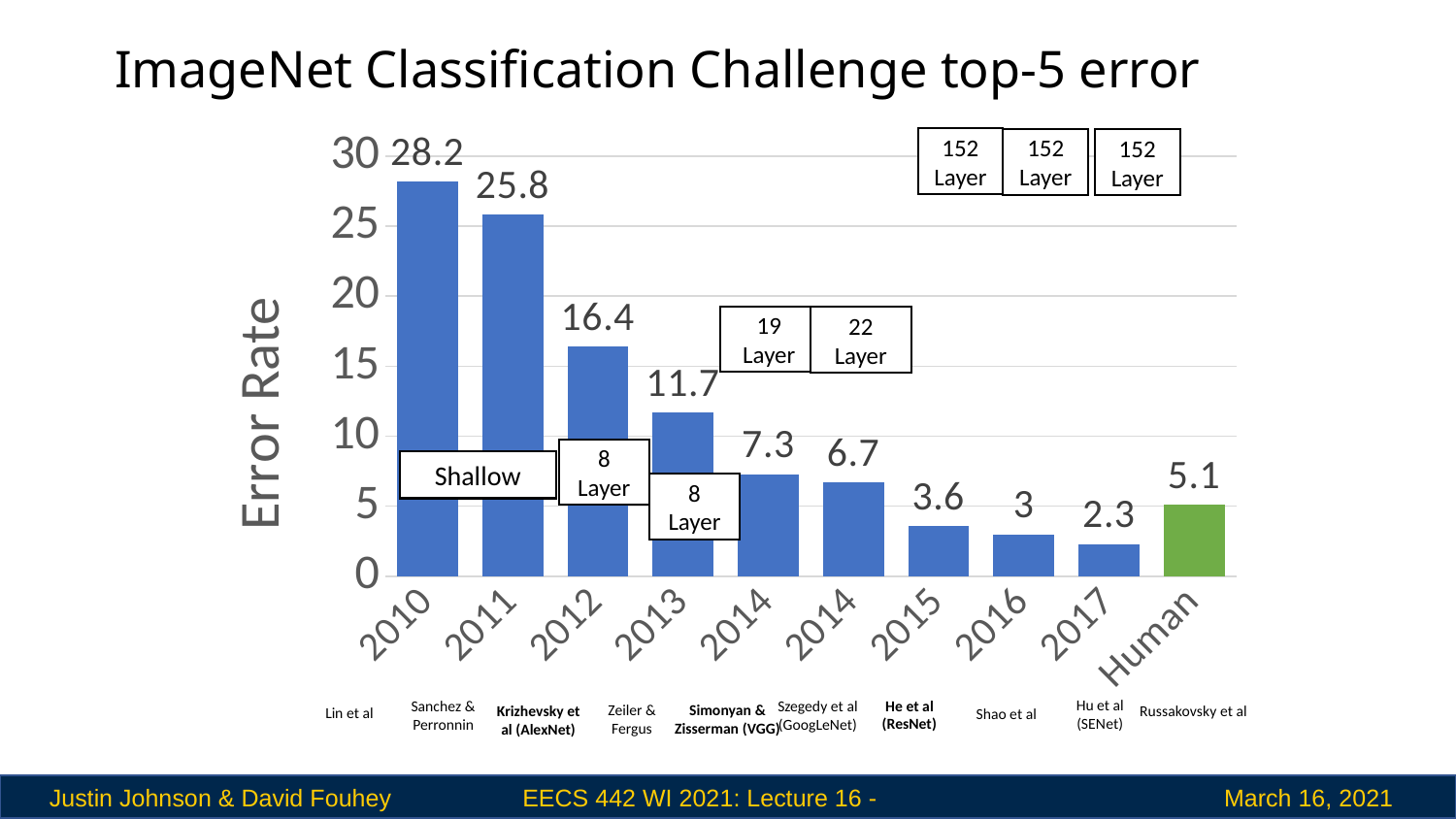
What is the difference in error rate between 2010 and 2011? 2.4 Which bar has the highest error rate? 2010 What is the error rate for the Human bar (Russakovsky et al)? 5.1 How many bars are shown in the chart? 10 What type of chart is shown on the slide? Bar chart Which bar has the lowest error rate? 2017 What is the error rate for 2017 (Hu et al, SENet)? 2.3 What is the difference in error rate between 2015 (He et al, ResNet) and the Human bar? 1.5 Which has a higher error rate, 2013 (Zeiler & Fergus) or the Human bar? 2013 What is the error rate for the 2014 bar labelled Szegedy et al (GoogLeNet)? 6.7 What is the error rate for 2010 (Lin et al)? 28.2 What is the error rate for 2012 (Krizhevsky et al, AlexNet)? 16.4